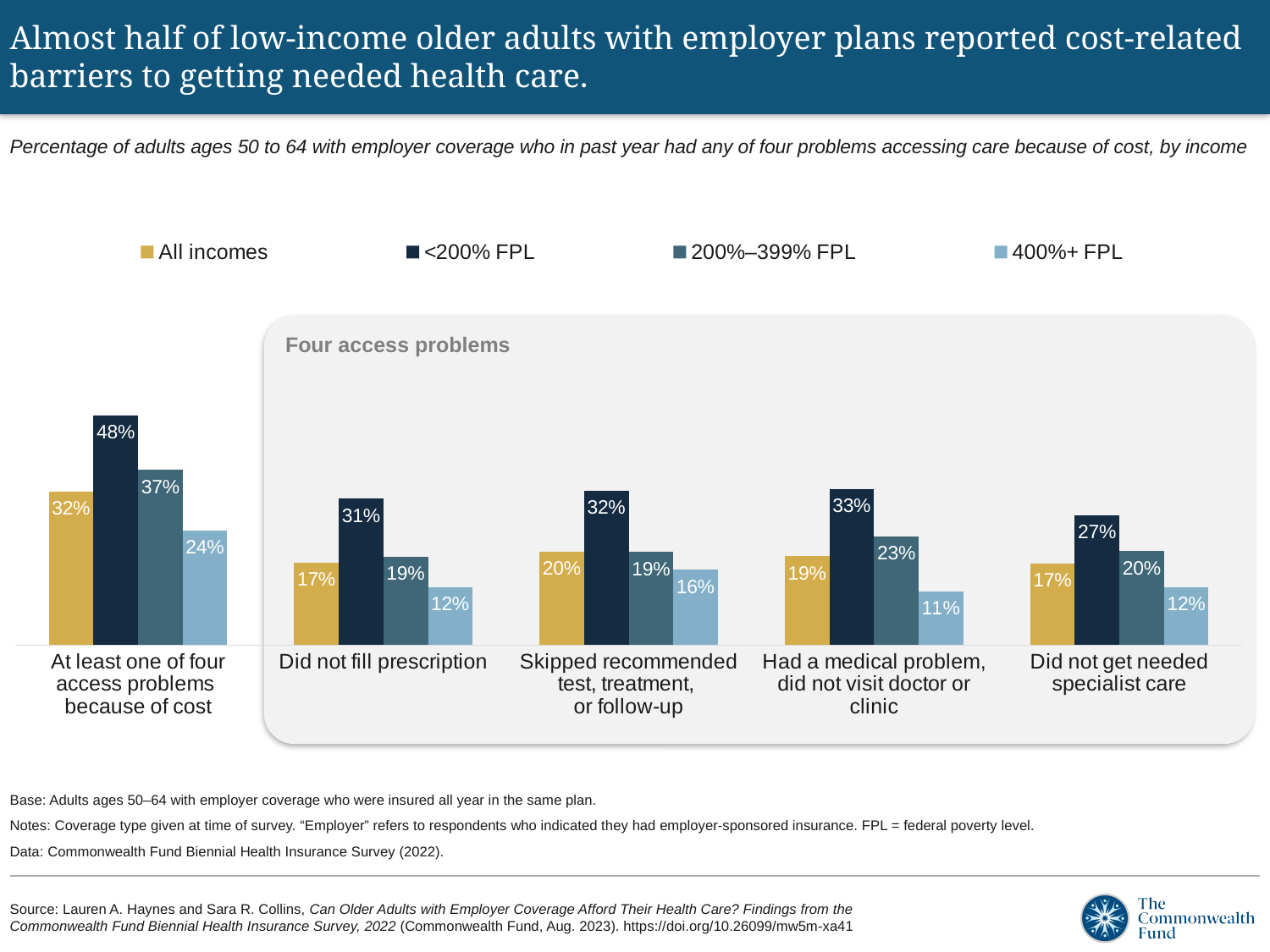
How many series does the legend list? 4 What kind of chart is shown on the slide? Bar chart What is the value for the 400%+ FPL group for 'Did not fill prescription'? 12% Which is larger: the 200%–399% FPL value for 'Skipped recommended test, treatment, or follow-up' or the 200%–399% FPL value for 'Had a medical problem, did not visit doctor or clinic'? Had a medical problem, did not visit doctor or clinic What is the difference between the <200% FPL and 400%+ FPL values for 'At least one of four access problems because of cost'? 24 percentage points What percentage of all incomes skipped recommended test, treatment, or follow-up? 20% What is the value for the 200%–399% FPL group for 'Had a medical problem, did not visit doctor or clinic'? 23% Which income group has the lowest value for 'Had a medical problem, did not visit doctor or clinic'? 400%+ FPL What percentage of adults with incomes below 200% FPL reported at least one of four access problems because of cost? 48% How many categories are shown on the x axis? 5 What is the difference between the <200% FPL and All incomes values for 'Did not fill prescription'? 14 percentage points Which income group has the highest value for 'Did not get needed specialist care'? <200% FPL